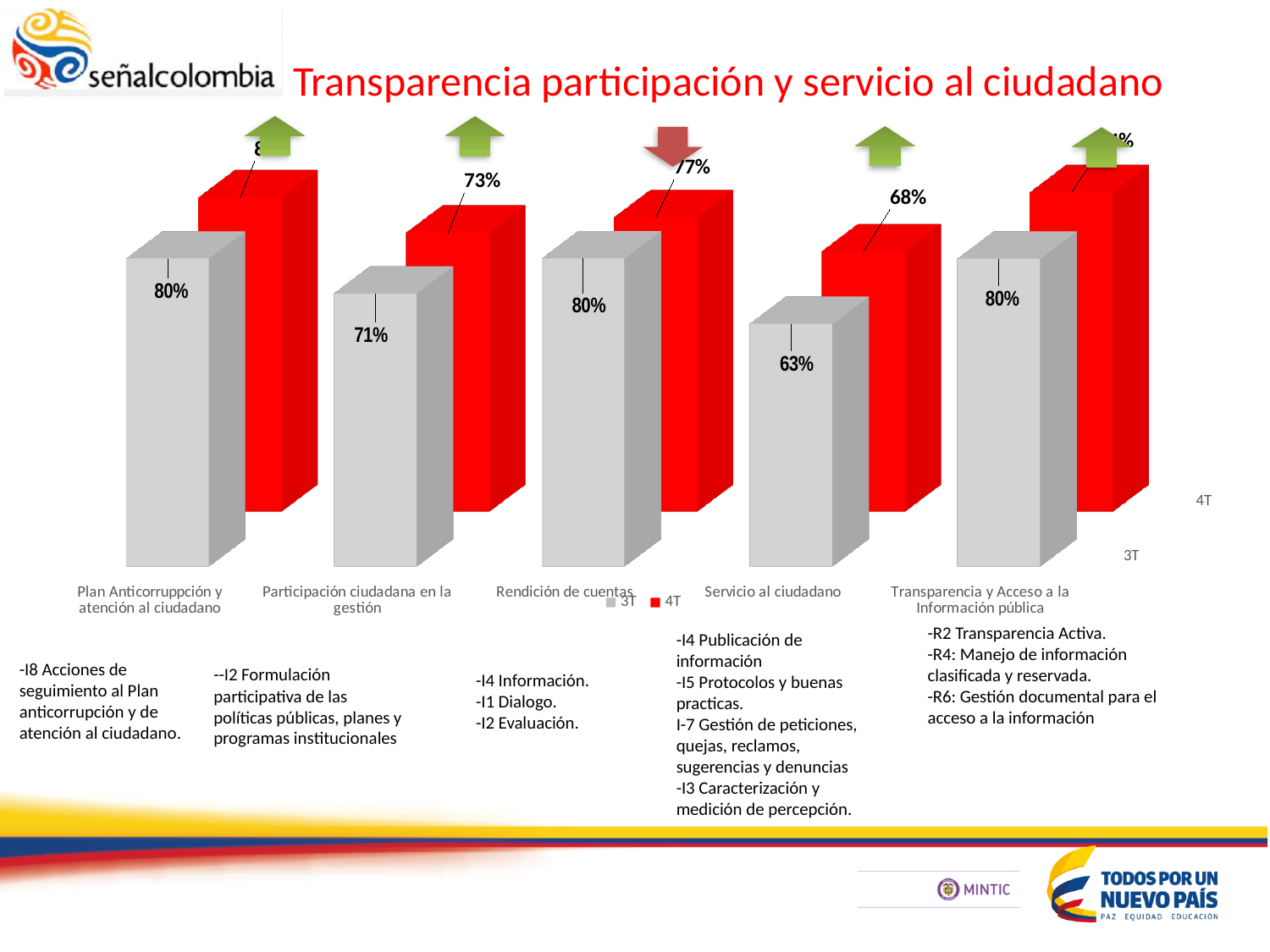
What is the 4T value for Participación ciudadana en la gestión? 73% What is the 4T value for Rendición de cuentas? 77% What is the 4T value for Servicio al ciudadano? 68% What kind of chart is shown on the slide? Bar chart What is the 3T value for Participación ciudadana en la gestión? 71% For Rendición de cuentas, which series has the larger value, 3T or 4T? 3T By how many percentage points does the 4T value exceed the 3T value for Servicio al ciudadano? 5 percentage points How many series does the legend list? 2 How many categories are shown on the x axis of the chart? 5 What is the 3T value for Servicio al ciudadano? 63% What is the difference between the 4T and 3T values for Participación ciudadana en la gestión? 2 percentage points Which category has the lowest 3T value? Servicio al ciudadano